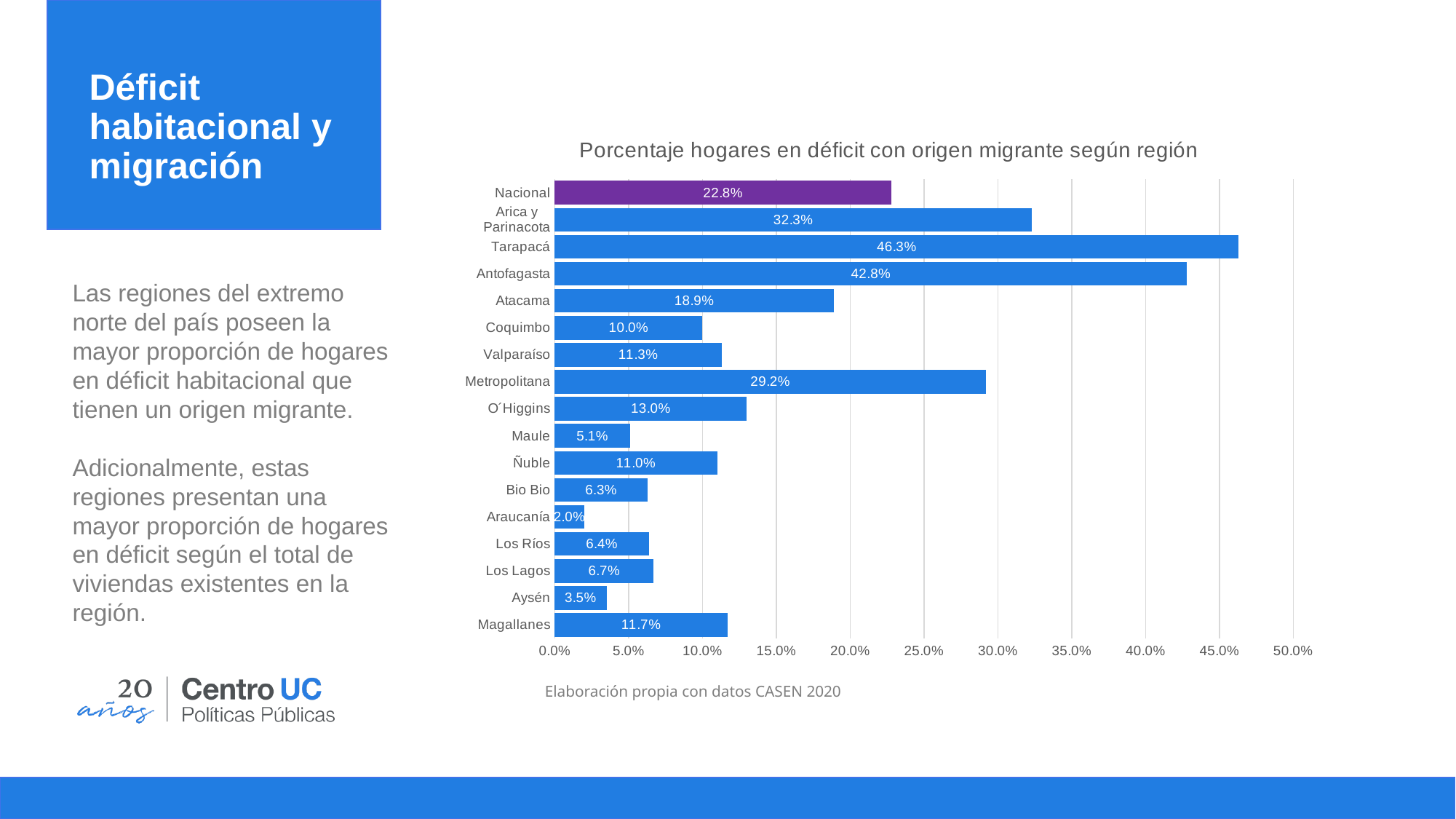
Which region has the highest percentage? Tarapacá What is the value for Nacional? 22.8% What is the value for Metropolitana? 29.2% Which is larger, Arica y Parinacota or Metropolitana? Arica y Parinacota How many categories (bars) are shown in the chart? 17 What kind of chart is shown on the slide? Bar chart What is the difference between Tarapacá and Antofagasta? 3.5% What is the value for Tarapacá? 46.3% What is the difference between Metropolitana and Nacional? 6.4% What is the title of the chart? Porcentaje hogares en déficit con origen migrante según región Which region has the lowest percentage? Araucanía What is the value for Magallanes? 11.7%